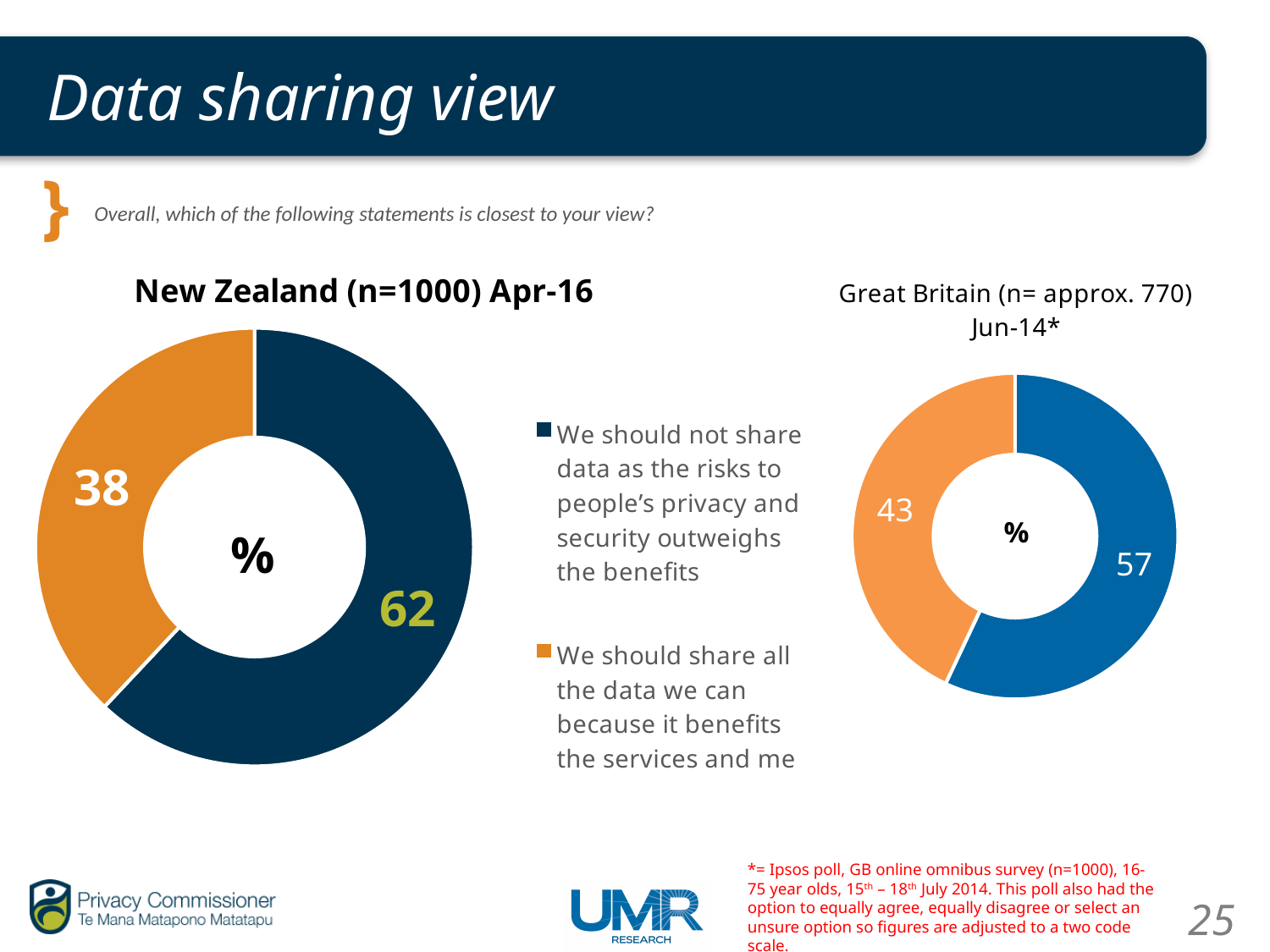
In the Great Britain (n= approx. 770) Jun-14 chart, which statement has the smaller share? We should share all the data we can because it benefits the services and me What kind of chart is used for the New Zealand (n=1000) Apr-16 data? Donut (pie) chart In the New Zealand (n=1000) Apr-16 chart, what percentage chose "We should not share data as the risks to people's privacy and security outweighs the benefits"? 62 Which colour represents "We should share all the data we can because it benefits the services and me" in the legend? Orange In the New Zealand (n=1000) Apr-16 chart, which statement has the larger share? We should not share data as the risks to people's privacy and security outweighs the benefits In the Great Britain (n= approx. 770) Jun-14 chart, what is the difference between the "should not share" and "should share all" percentages? 14 In the Great Britain (n= approx. 770) Jun-14 chart, what percentage chose "We should not share data as the risks to people's privacy and security outweighs the benefits"? 57 In the Great Britain (n= approx. 770) Jun-14 chart, what percentage chose "We should share all the data we can because it benefits the services and me"? 43 In the New Zealand (n=1000) Apr-16 chart, what is the difference between the "should not share" and "should share all" percentages? 24 How many statements does the legend list? 2 Is the "We should not share data" percentage larger in the New Zealand chart or the Great Britain chart? New Zealand In the New Zealand (n=1000) Apr-16 chart, what percentage chose "We should share all the data we can because it benefits the services and me"? 38